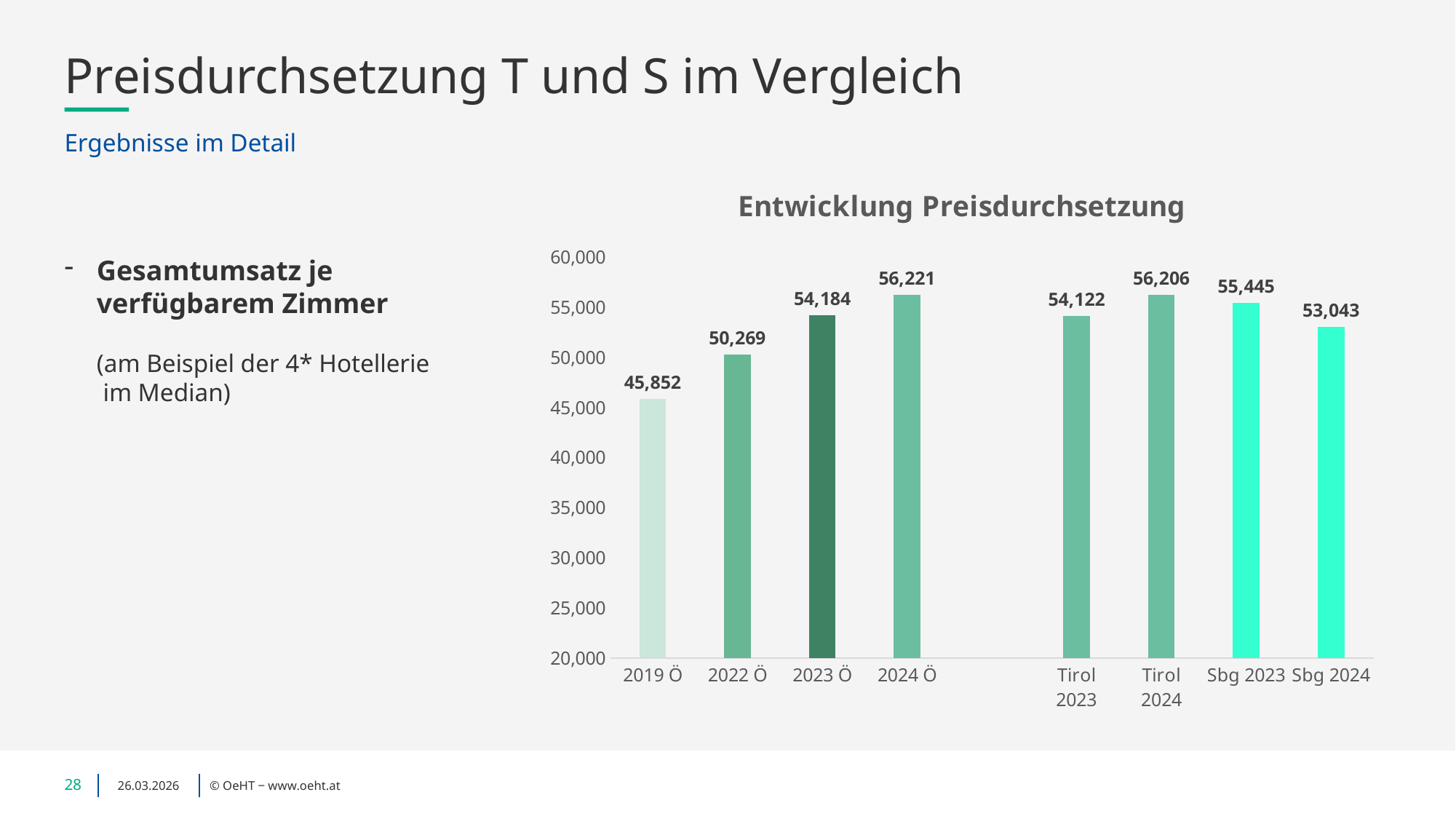
What is the value for Sbg 2023 in the chart? 55,445 Which is larger, the value for Sbg 2023 or Sbg 2024? Sbg 2023 What is the difference between the values for Tirol 2024 and Tirol 2023? 2,084 What kind of chart is shown on the slide? bar chart Do the values for Ö rise or fall from 2019 Ö to 2024 Ö? rise What is the value for 2022 Ö in the chart? 50,269 What is the value for 2019 Ö in the chart? 45,852 Is the value for 2019 Ö greater or less than 50,000? less What is the difference between the values for 2024 Ö and 2019 Ö? 10,369 What is the value for Tirol 2024 in the chart? 56,206 How many bars are shown in the chart? 8 Which category has the lowest value in the chart? 2019 Ö